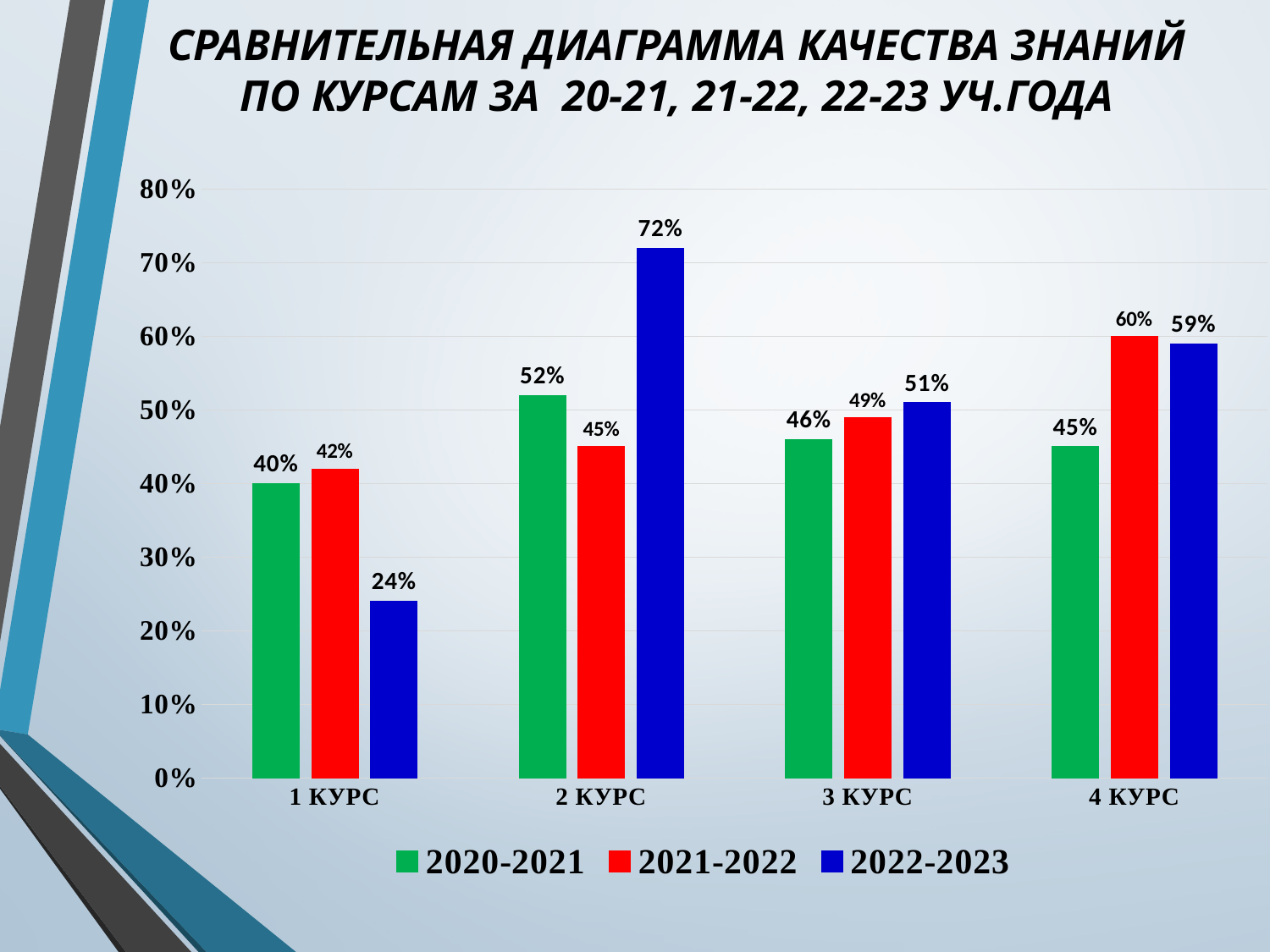
What is the value for 4 КУРС in the 2021-2022 series? 60% How many courses are shown on the x axis? 4 What is the value for 2 КУРС in the 2022-2023 series? 72% Which course has the highest value in the 2022-2023 series? 2 КУРС Which colour represents the 2021-2022 series in the legend? red How many series does the legend list? 3 What kind of chart is shown on the slide? bar chart What is the value for 1 КУРС in the 2020-2021 series? 40% Which is larger for 1 КУРС: the 2021-2022 value or the 2022-2023 value? 2021-2022 Is the value for 3 КУРС in the 2021-2022 series greater or less than 40%? greater What is the difference between the 2022-2023 and 2020-2021 values for 2 КУРС? 20% Which course has the lowest value in the 2022-2023 series? 1 КУРС